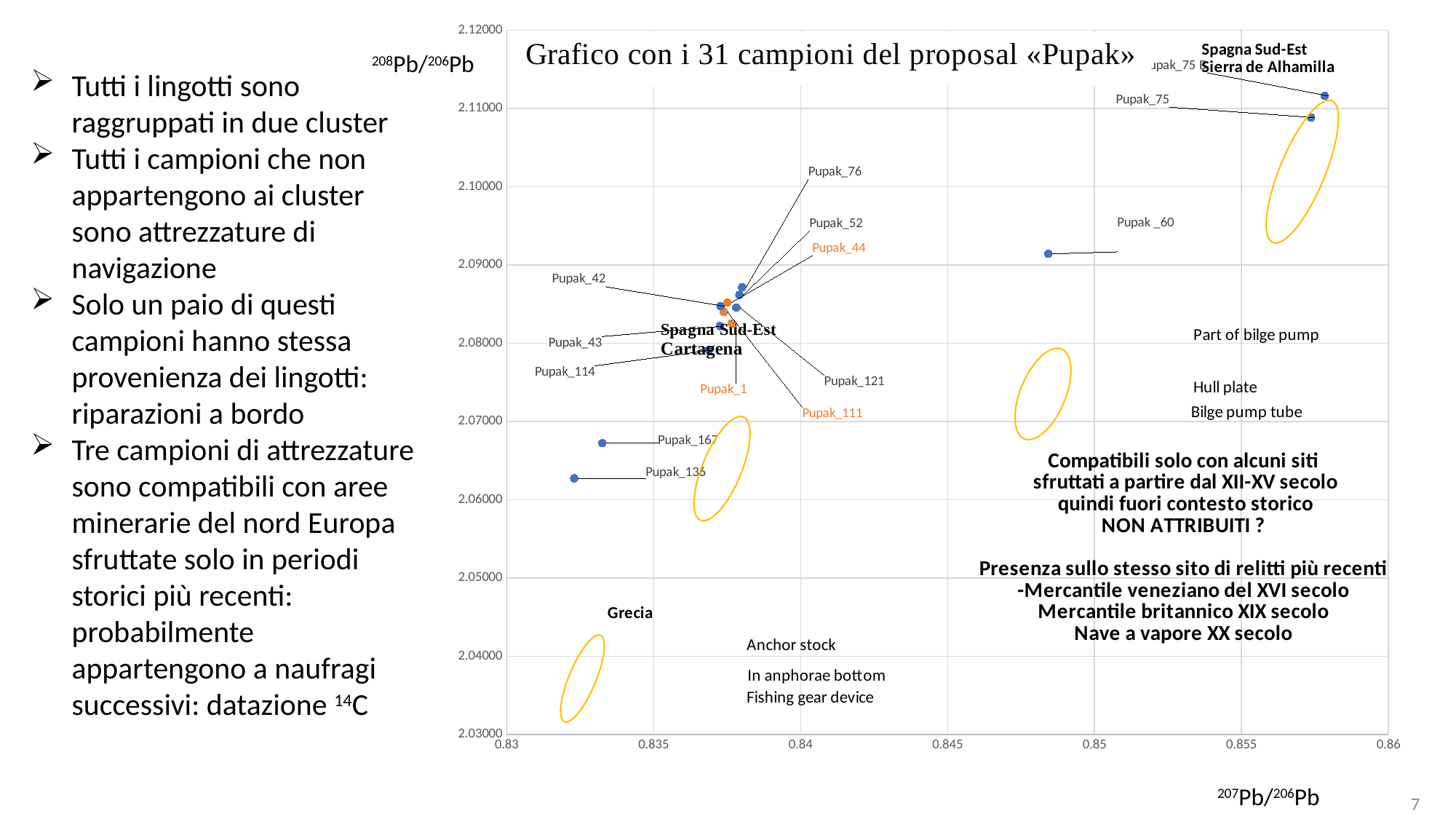
What quantity is plotted on the horizontal axis of the chart? 207Pb/206Pb Is the 207Pb/206Pb value for Pupak_75 greater or less than 0.855? greater Which has the larger 207Pb/206Pb value, Pupak_60 or Pupak_42? Pupak_60 What kind of chart is shown on the slide? scatter chart Is the 208Pb/206Pb value for Pupak_75 greater or less than 2.10? greater Which has the higher 208Pb/206Pb value, Pupak_75 or Pupak_136? Pupak_75 Is the 207Pb/206Pb value for Pupak_136 greater or less than 0.835? less Which labelled sample has the lowest 208Pb/206Pb value on the chart? Pupak_136 What is the title of the chart? Grafico con i 31 campioni del proposal «Pupak»